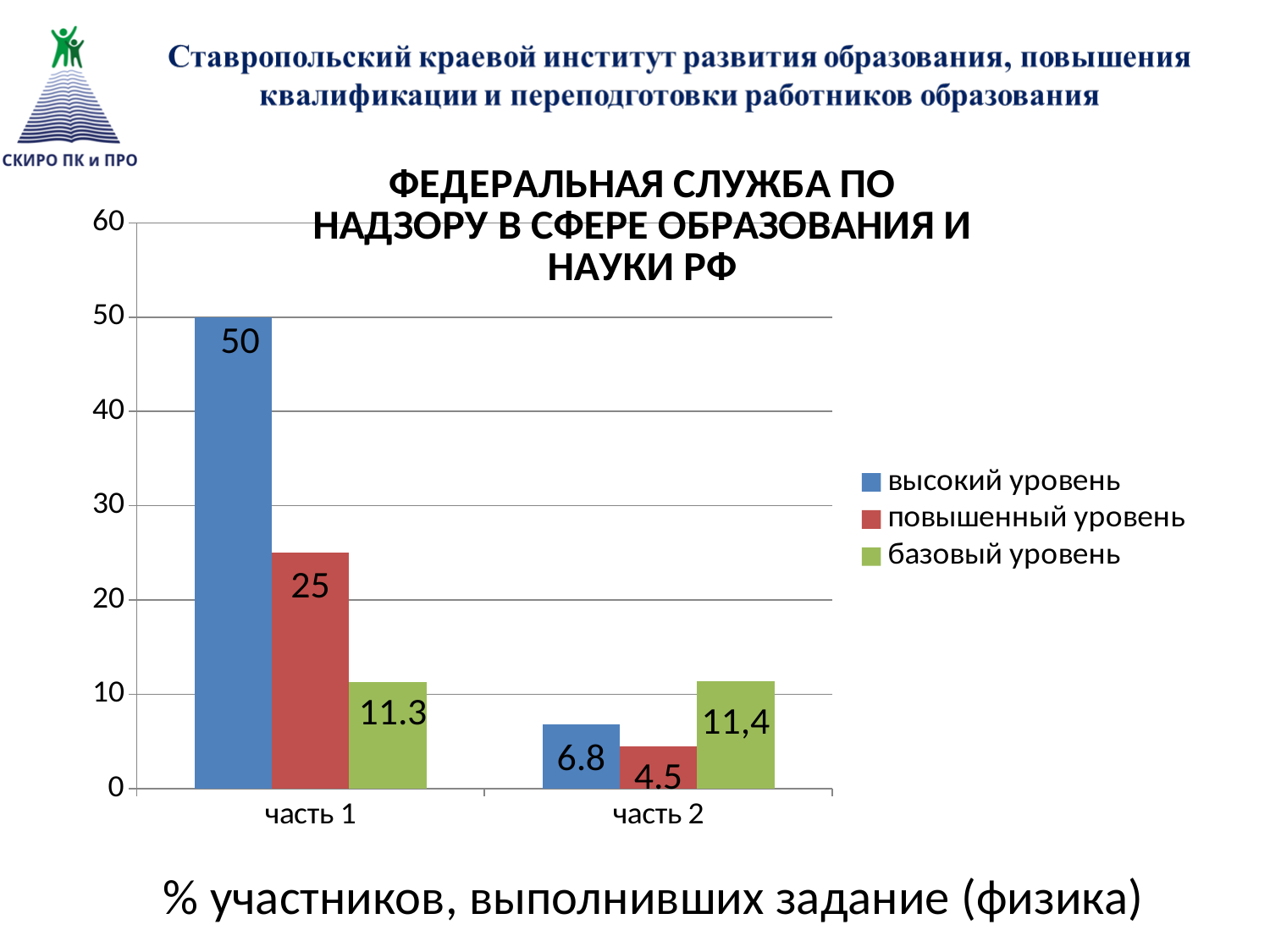
What kind of chart is shown on the slide? bar chart How many series does the legend list? 3 Which colour represents базовый уровень in the legend? green What is the value for повышенный уровень in часть 2? 4.5 What is the value for базовый уровень in часть 1? 11.3 Which series has the highest value in часть 1? высокий уровень What is the value for высокий уровень in часть 1? 50 What is the difference between высокий уровень and повышенный уровень in часть 1? 25 Which series has the lowest value in часть 2? повышенный уровень How many categories are shown on the x axis? 2 Which is larger: высокий уровень in часть 2 or повышенный уровень in часть 2? высокий уровень in часть 2 What is the value for базовый уровень in часть 2? 11,4